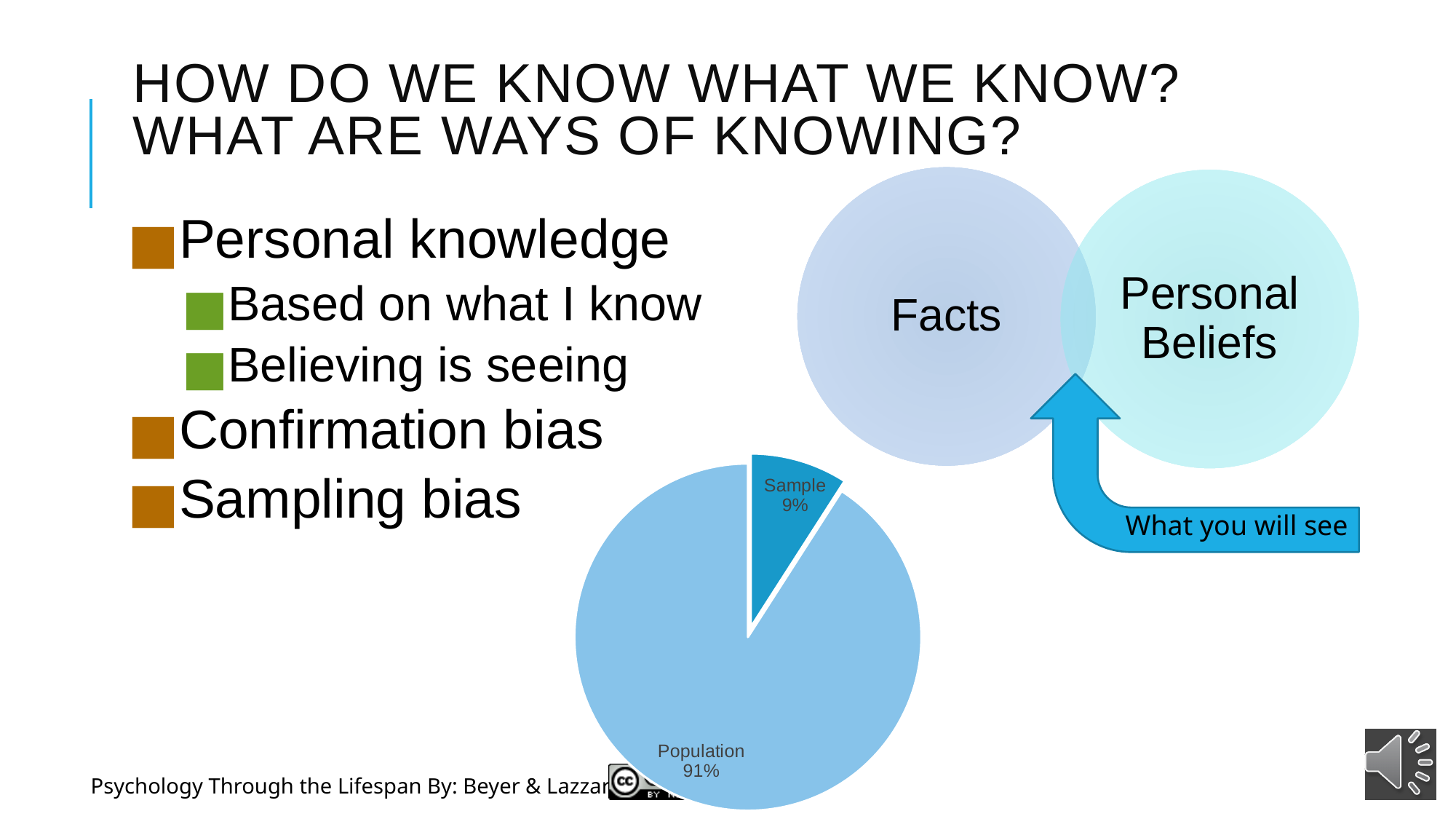
Which is larger in the pie chart, Sample or Population? Population What is the total of the two percentages shown on the pie chart? 100% What share of the pie chart does the Population slice represent? 91% Which slice of the pie chart is pulled out (exploded) from the rest? Sample What kind of chart is shown at the bottom of the slide? pie chart Which slice of the pie chart is the largest? Population What is the difference in percentage points between the Population and Sample slices? 82 How many slices does the pie chart have? 2 What share of the pie chart does the Sample slice represent? 9% Which slice of the pie chart is the smallest? Sample